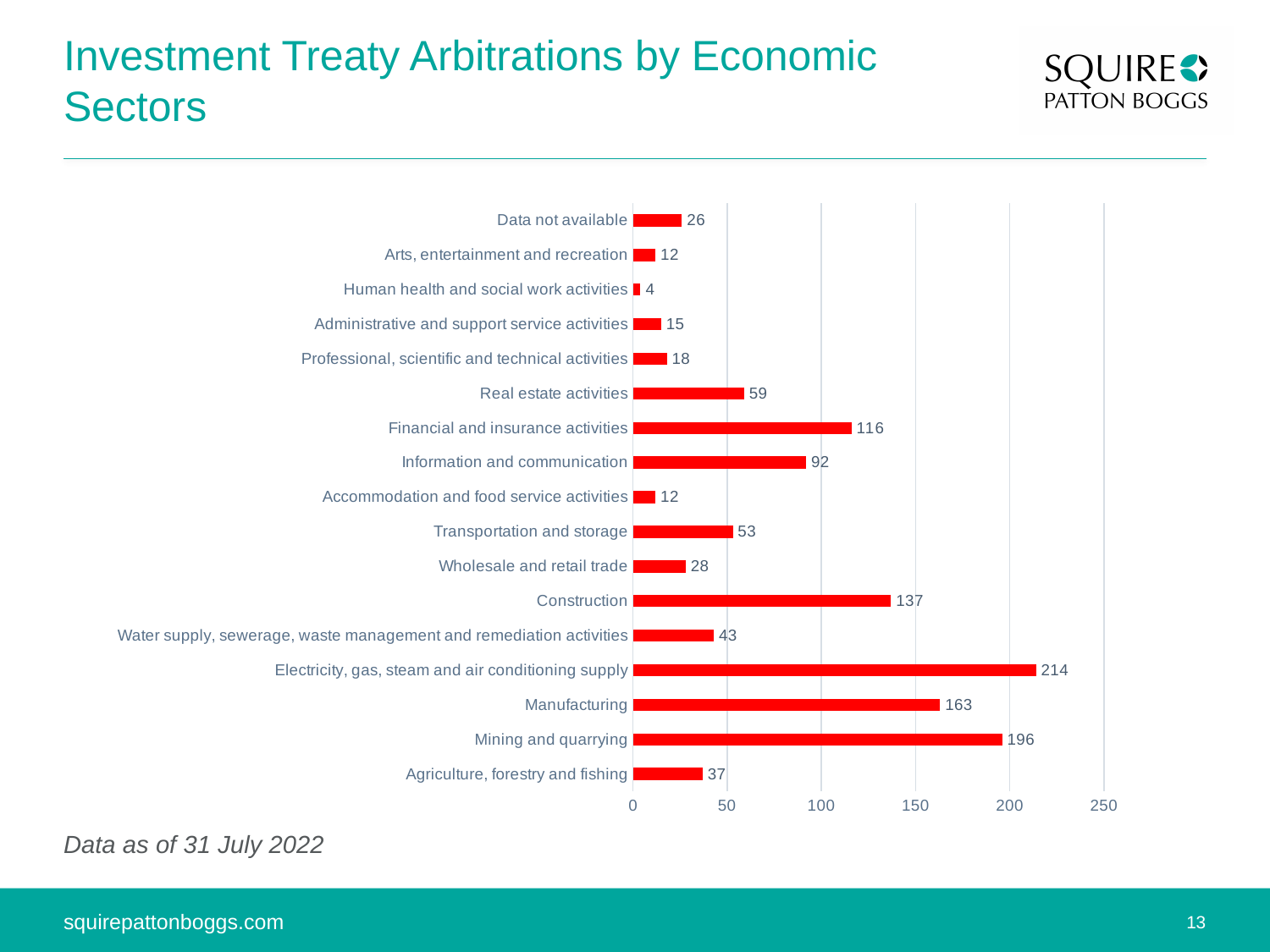
What is the value for Financial and insurance activities? 116 What is the difference between the values for Mining and quarrying and Manufacturing? 33 What is the title of the chart on the slide? Investment Treaty Arbitrations by Economic Sectors Which economic sector has the lowest number of investment treaty arbitrations? Human health and social work activities What kind of chart is shown on the slide? Bar chart What is the difference between the values for Electricity, gas, steam and air conditioning supply and Construction? 77 Is the value for Information and communication greater or less than 100? less What is the value for Construction? 137 Which is larger, the value for Real estate activities or the value for Transportation and storage? Real estate activities How many economic sector categories are shown in the chart? 17 What is the value for Agriculture, forestry and fishing? 37 Which economic sector has the highest number of investment treaty arbitrations? Electricity, gas, steam and air conditioning supply